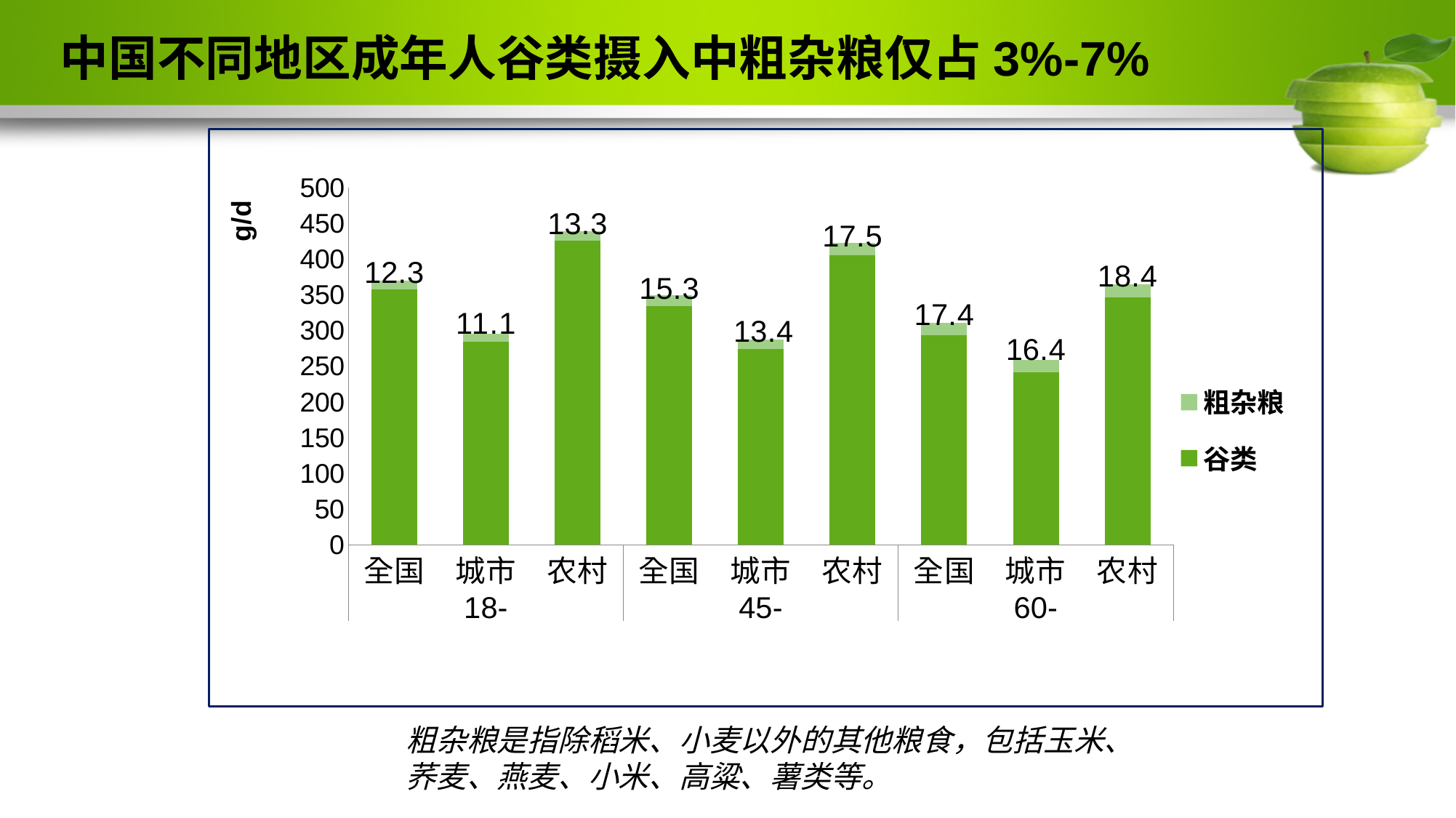
How many series does the legend list? 2 What is the 粗杂粮 value for 城市 in the 45- group? 13.4 Is the total bar height for 农村 45- greater or less than 400? greater How many bars are shown in the chart? 9 What type of chart is shown? Stacked bar chart What is the 粗杂粮 value for 全国 in the 18- group? 12.3 Which category has the highest 粗杂粮 value? 农村 60- Which has a taller total bar, 农村 18- or 城市 18-? 农村 18- What is the difference between the 粗杂粮 values for 农村 45- and 城市 45-? 4.1 What is the 粗杂粮 value for 农村 in the 60- group? 18.4 Is the total bar height for 城市 60- greater or less than 300? less Which category has the lowest 粗杂粮 value? 城市 18-